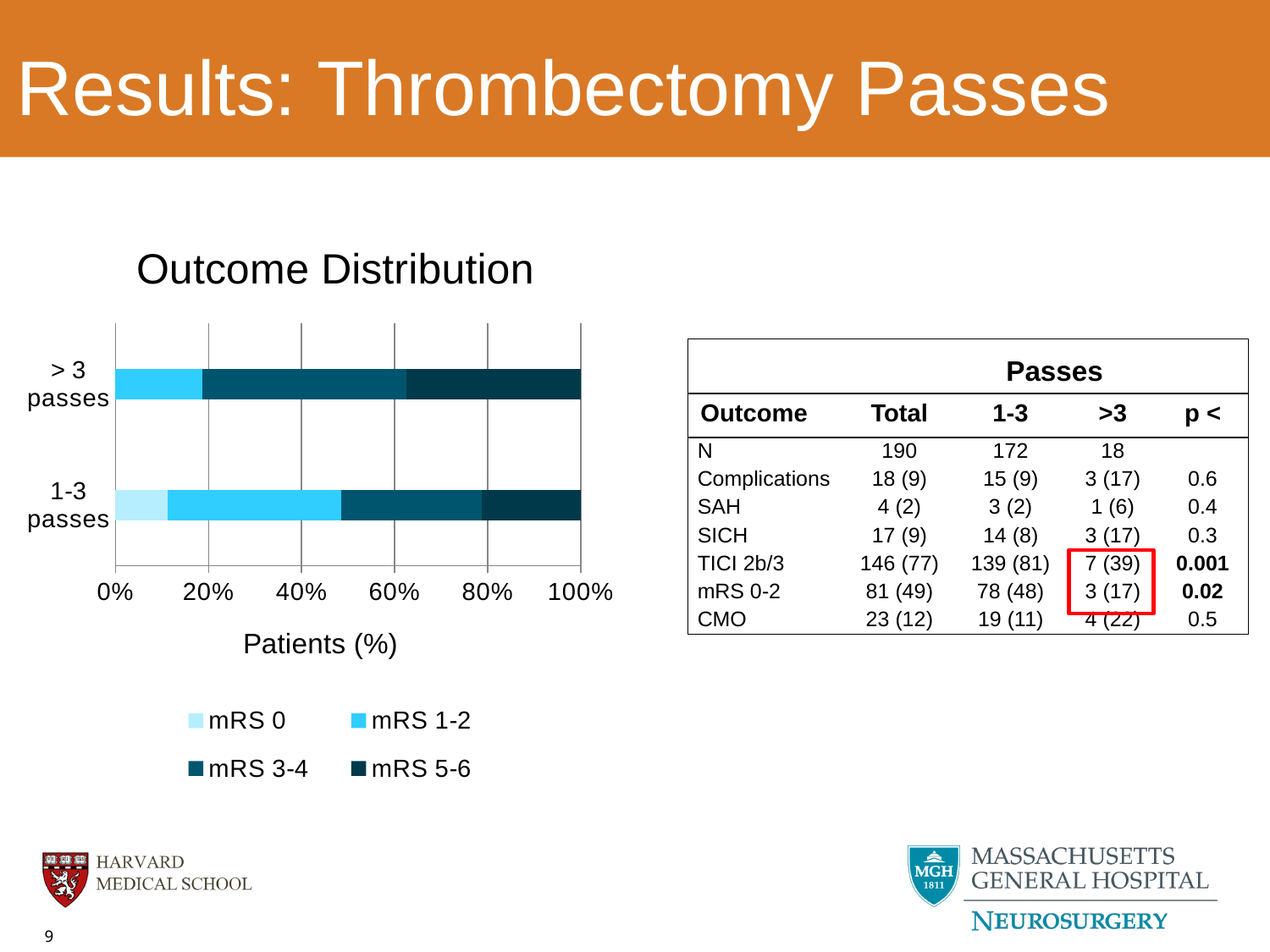
In the Outcome Distribution chart, is the mRS 1-2 share for '1-3 passes' greater or less than 20%? greater What is the title of the bar chart on the slide? Outcome Distribution In the Outcome Distribution chart, is the mRS 5-6 share for '> 3 passes' greater or less than 20%? greater In the Outcome Distribution chart, is the mRS 1-2 share for '> 3 passes' greater or less than 40%? less What kind of chart is the Outcome Distribution chart? stacked bar chart What is the x-axis label of the Outcome Distribution chart? Patients (%) In the Outcome Distribution chart, which category has the larger mRS 1-2 segment, '> 3 passes' or '1-3 passes'? 1-3 passes How many categories (bars) are shown in the Outcome Distribution chart? 2 In the Outcome Distribution chart, which category has the larger mRS 5-6 segment, '> 3 passes' or '1-3 passes'? > 3 passes How many series does the legend of the Outcome Distribution chart list? 4 In the Outcome Distribution chart, which category has the larger mRS 0 segment, '> 3 passes' or '1-3 passes'? 1-3 passes